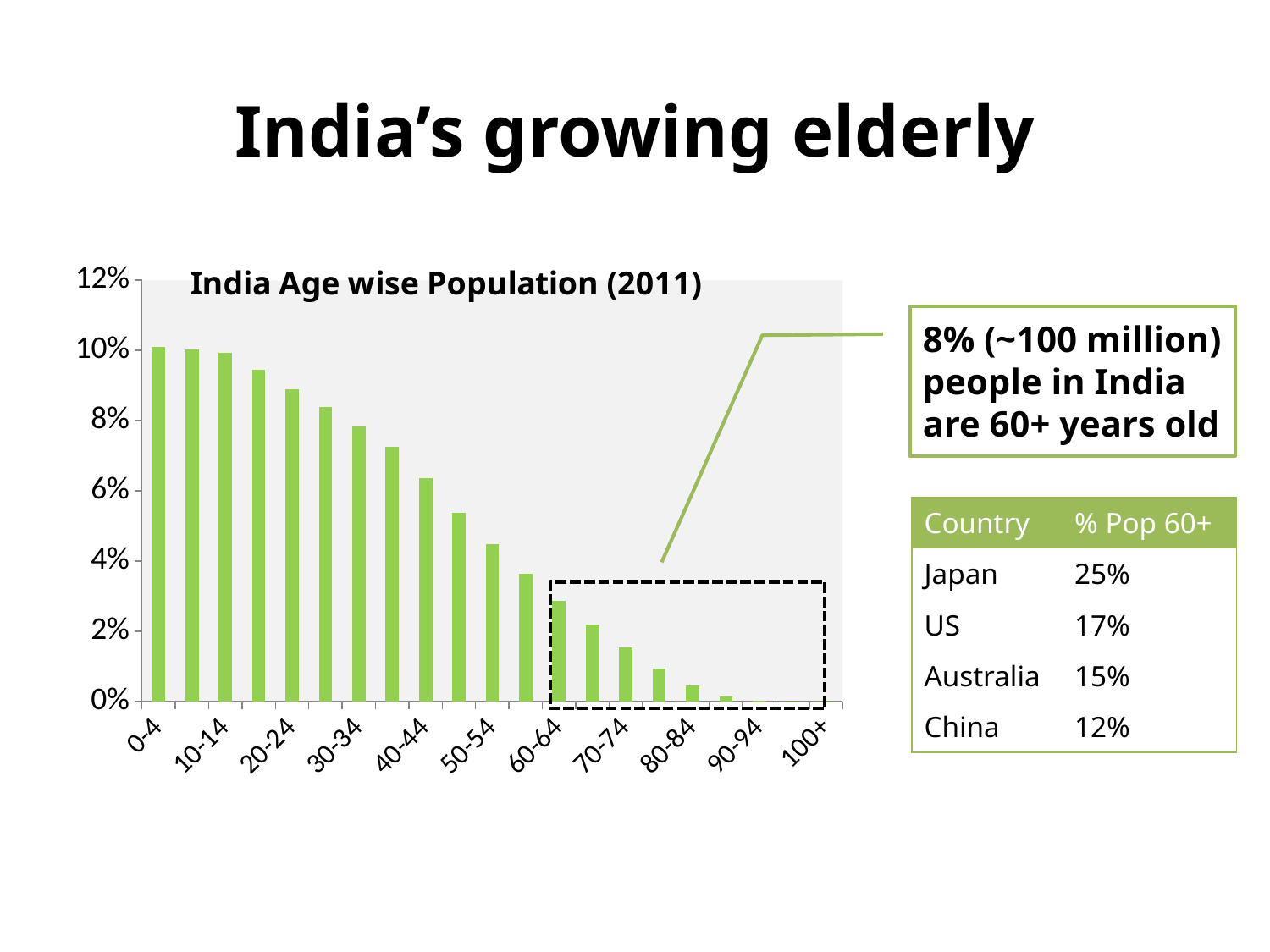
What is the title of the chart? India Age wise Population (2011) Is the value for the 0-4 age group greater or less than 8%? greater Do the bar values rise or fall as the age groups increase along the x axis? fall Which age group has the larger value, 0-4 or 60-64? 0-4 Is the value for the 70-74 age group greater or less than 2%? less Which age group has the larger value, 20-24 or 50-54? 20-24 Is the value for the 30-34 age group greater or less than 6%? greater What kind of chart is shown on the slide? bar chart According to the callout next to the chart, what percentage of people in India are 60+ years old? 8%